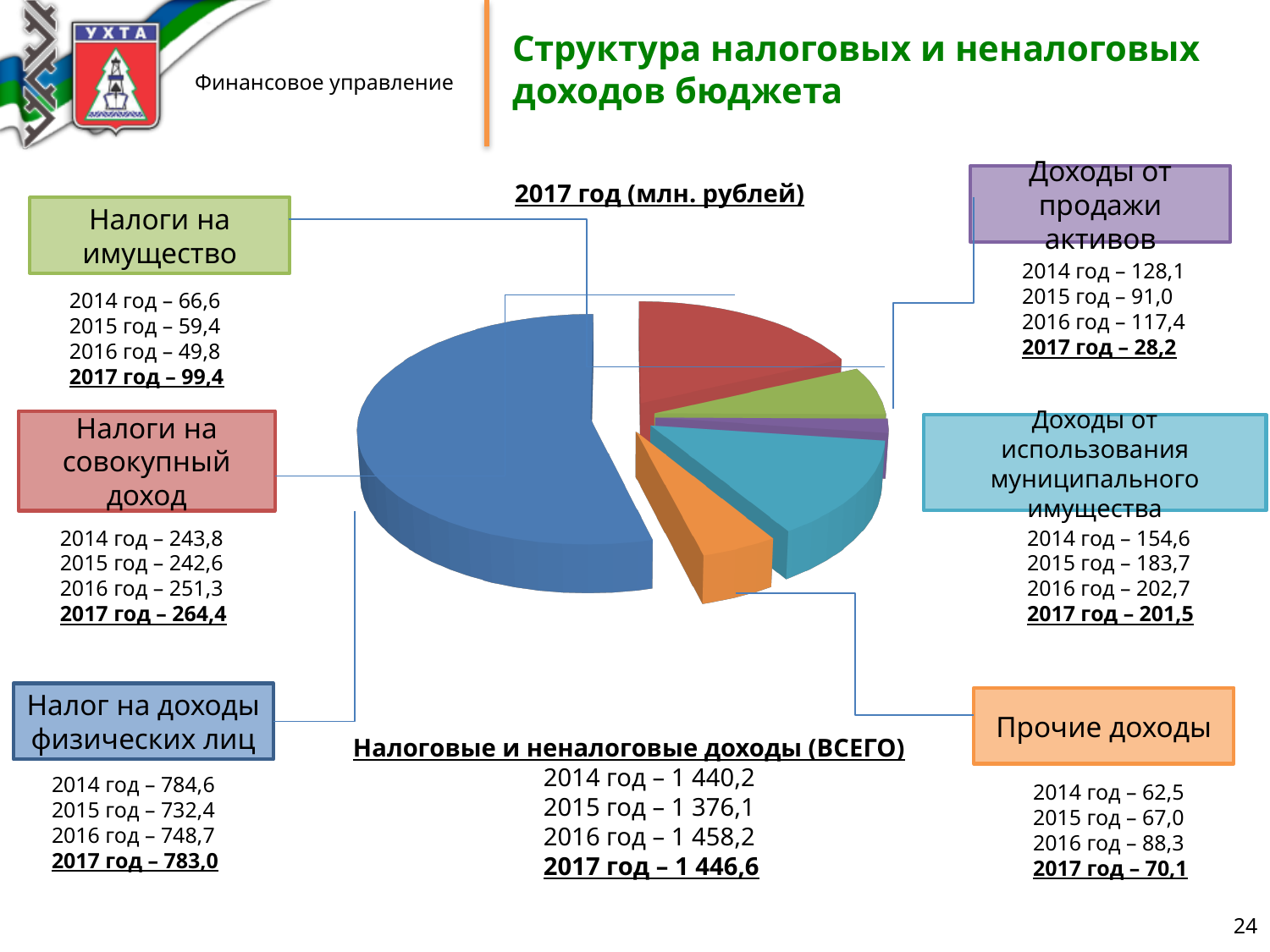
What unit is stated in the chart title for the 2017 values? млн. рублей What is the difference between the 2017 values for Налоги на совокупный доход and Доходы от использования муниципального имущества? 62,9 Which category has the smallest slice in the 2017 pie chart? Доходы от продажи активов Which category has the largest slice in the 2017 pie chart? Налог на доходы физических лиц What is the total of all tax and non-tax revenues (ВСЕГО) for 2017? 1 446,6 What is the 2017 value for Доходы от использования муниципального имущества? 201,5 What is the 2017 value for Налоги на совокупный доход? 264,4 Which is larger in 2017: Налоги на имущество or Прочие доходы? Налоги на имущество What is the 2017 value for Прочие доходы? 70,1 What kind of chart is shown on the slide? pie chart How many slices does the pie chart have? 6 What is the 2017 value for Налог на доходы физических лиц? 783,0